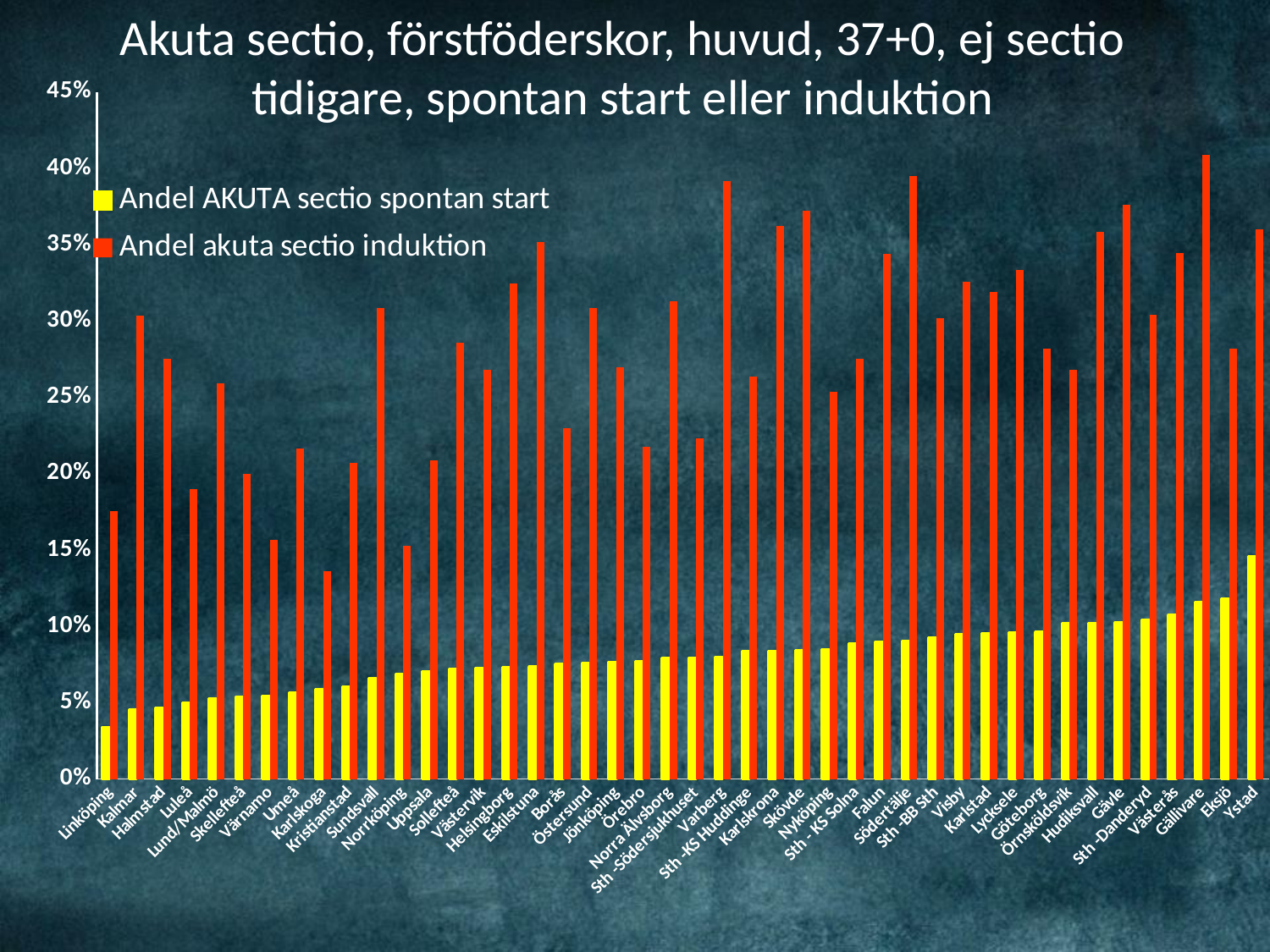
Which hospital has the lowest value for Andel akuta sectio induktion? Karlskoga What type of chart is shown on the slide? bar chart Which hospital has the highest value for Andel AKUTA sectio spontan start? Ystad Which colour represents Andel akuta sectio induktion in the legend? red Which is larger, the Andel akuta sectio induktion value for Kalmar or for Halmstad? Kalmar Which hospital has the highest value for Andel akuta sectio induktion? Gällivare Is the value for Andel akuta sectio induktion at Linköping greater or less than 15%? greater Do the values for Andel AKUTA sectio spontan start rise or fall from left to right along the x axis? rise Is the value for Andel AKUTA sectio spontan start at Ystad greater or less than 10%? greater Is the value for Andel akuta sectio induktion at Varberg greater or less than 35%? greater Which hospital has the lowest value for Andel AKUTA sectio spontan start? Linköping How many series does the legend list? 2